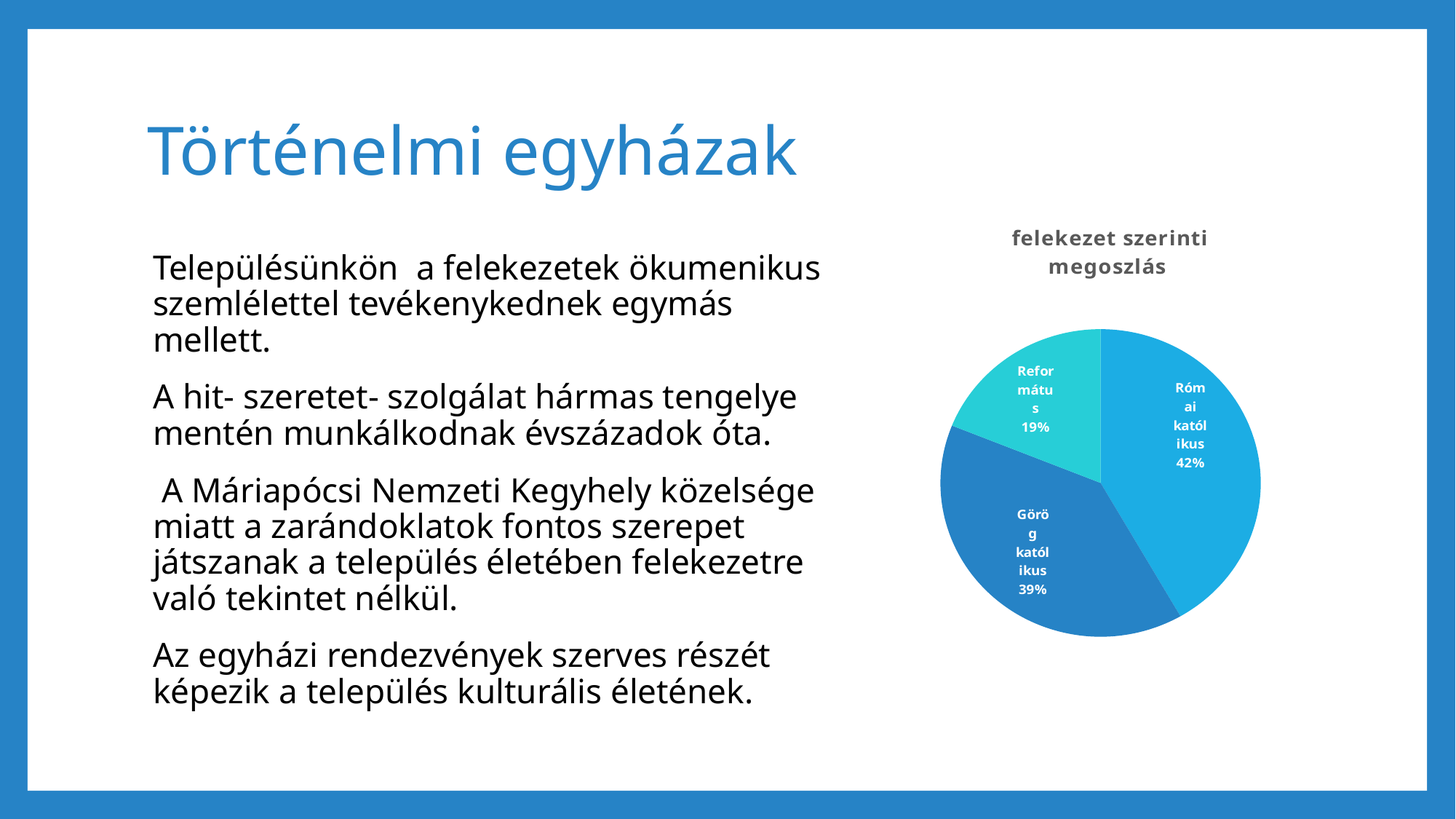
How many slices does the pie chart have? 3 Which denomination has the smallest slice of the pie? Református What share of the pie does Református have? 19% What share of the pie does Római katólikus have? 42% Which is larger, the Görög katólikus slice or the Református slice? Görög katólikus What is the difference in percentage points between Görög katólikus and Református? 20% What kind of chart is shown on the slide? pie chart What share of the pie does Görög katólikus have? 39% What is the title of the chart? felekezet szerinti megoszlás What is the difference in percentage points between Római katólikus and Református? 23% Which denomination has the largest slice of the pie? Római katólikus What is the combined share of Római katólikus and Görög katólikus? 81%